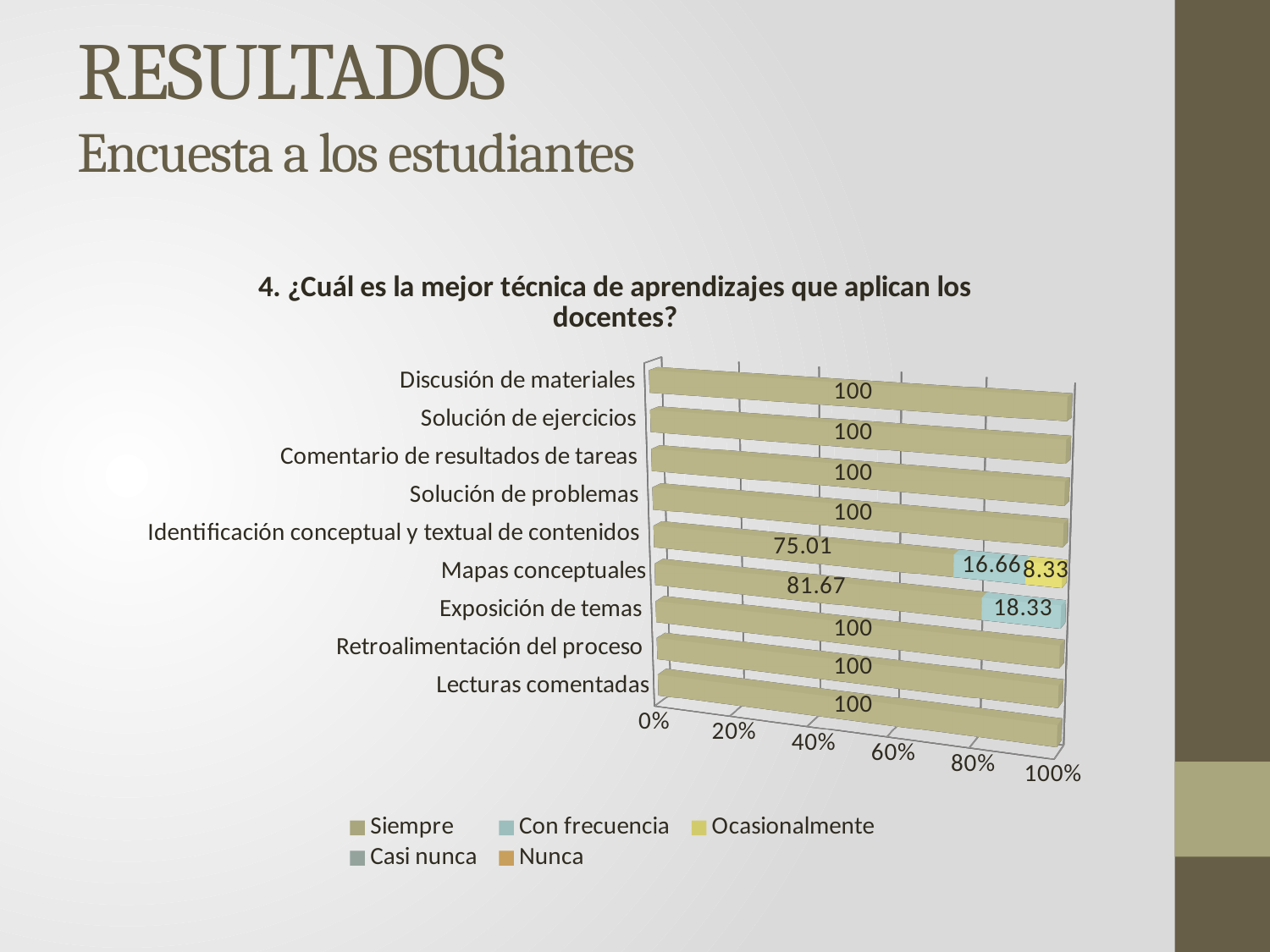
What type of chart is shown on the slide? Stacked bar chart What is the title of the chart? 4. ¿Cuál es la mejor técnica de aprendizajes que aplican los docentes? Which is larger: the Con frecuencia value for Mapas conceptuales or for Identificación conceptual y textual de contenidos? Mapas conceptuales What is the Ocasionalmente value for Identificación conceptual y textual de contenidos? 8.33 What is the Con frecuencia value for Mapas conceptuales? 18.33 Which category has the lowest Siempre value? Identificación conceptual y textual de contenidos What is the Siempre value for Lecturas comentadas? 100 What is the Siempre value for Mapas conceptuales? 81.67 How many categories (learning techniques) are listed on the chart? 9 What is the difference between the Siempre values for Mapas conceptuales and Identificación conceptual y textual de contenidos? 6.66 How many series does the chart legend list? 5 What is the Siempre value for Identificación conceptual y textual de contenidos? 75.01